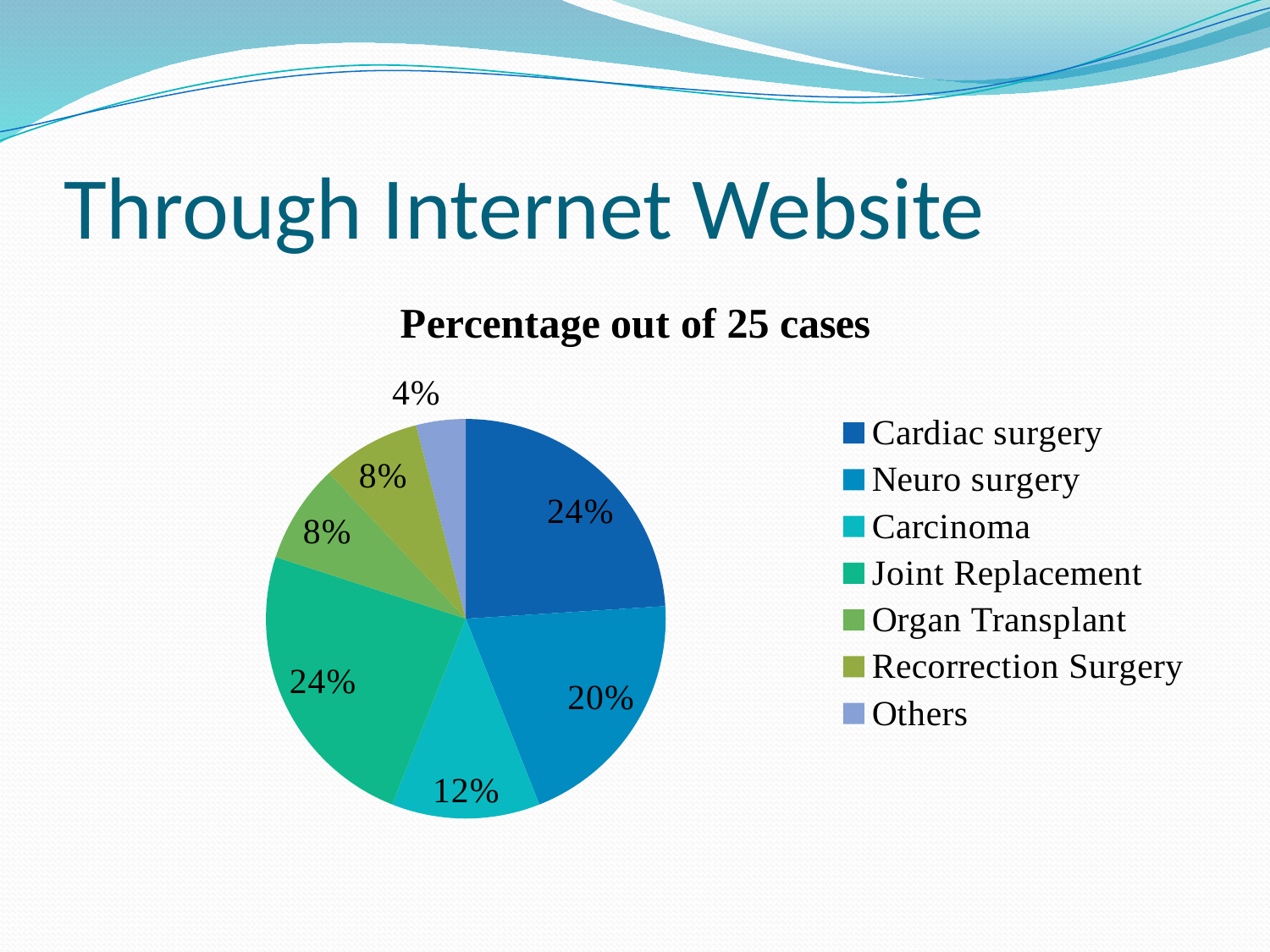
What is the share of the pie for Carcinoma? 12% What percentage of cases does Neuro surgery account for? 20% What is the difference in percentage points between Neuro surgery and Carcinoma? 8 Which legend entry is listed last? Others Which is larger, the share for Cardiac surgery or the share for Neuro surgery? Cardiac surgery What is the difference in percentage points between Organ Transplant and Others? 4 How many categories does the pie chart show? 7 What is the title of the chart? Percentage out of 25 cases What percentage is shown for Others? 4% Which category has the smallest slice of the pie? Others What percentage is shown for Joint Replacement? 24% What kind of chart is shown on the slide? Pie chart